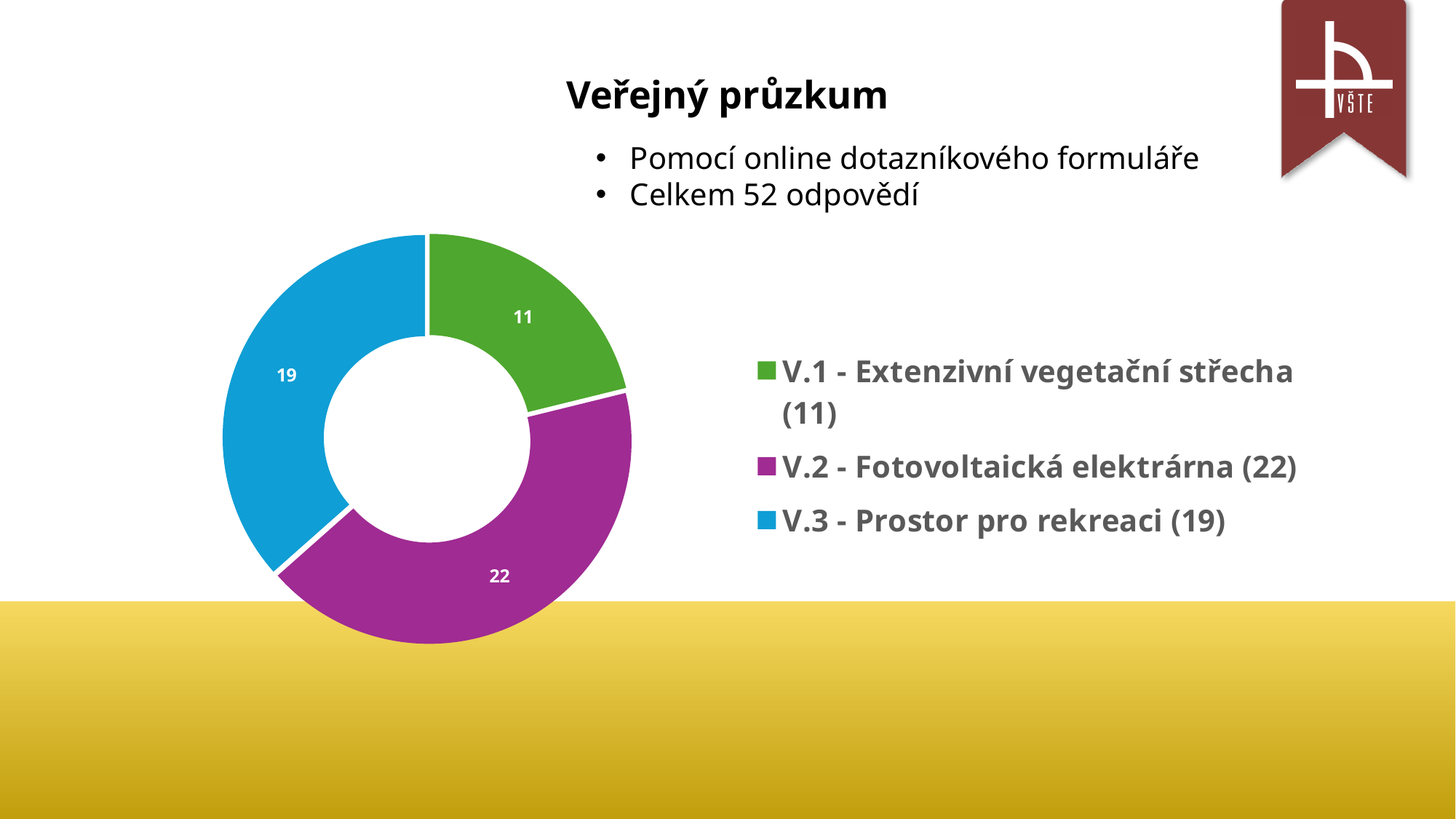
Which category has the lowest value? V.1 - Extenzivní vegetační střecha What is the value for V.2 - Fotovoltaická elektrárna? 22 What type of chart is shown on the slide? doughnut chart Which is larger, the value for V.3 - Prostor pro rekreaci or V.1 - Extenzivní vegetační střecha? V.3 - Prostor pro rekreaci What is the total of all slices in the doughnut chart? 52 Which category has the highest value? V.2 - Fotovoltaická elektrárna What is the value for V.1 - Extenzivní vegetační střecha? 11 What is the difference between the values for V.2 - Fotovoltaická elektrárna and V.3 - Prostor pro rekreaci? 3 How many entries does the legend list? 3 How many slices does the doughnut chart have? 3 What is the value for V.3 - Prostor pro rekreaci? 19 What colour is the slice for V.2 - Fotovoltaická elektrárna? purple